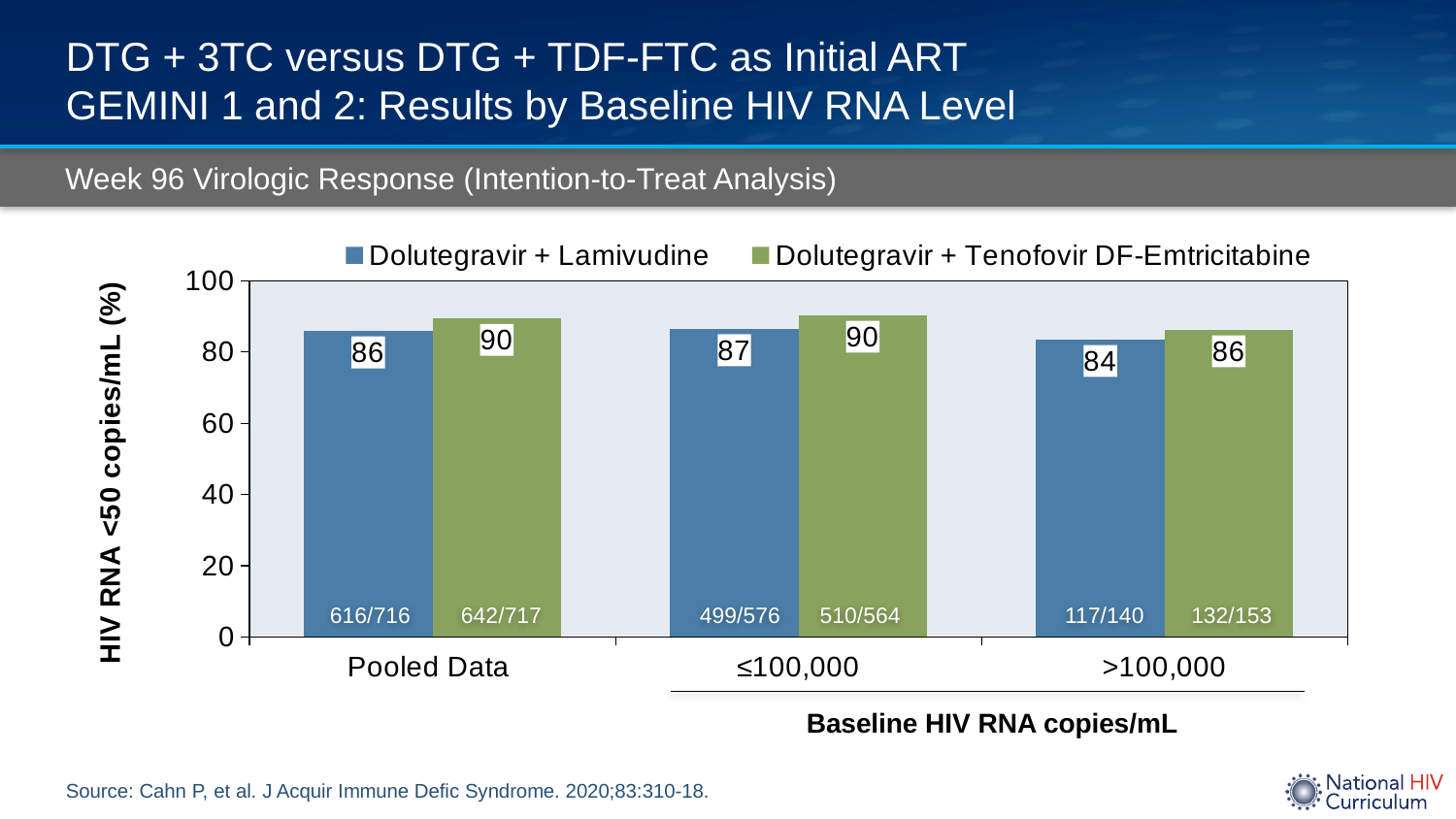
Which category has the lowest value for Dolutegravir + Lamivudine? >100,000 What fraction is printed on the Dolutegravir + Lamivudine bar in the ≤100,000 category? 499/576 What is the value for Dolutegravir + Tenofovir DF-Emtricitabine in the >100,000 category? 86 What is the label of the y axis? HIV RNA <50 copies/mL (%) Is the value for Dolutegravir + Lamivudine in the >100,000 category greater or less than 80? greater What is the value for Dolutegravir + Lamivudine in the ≤100,000 category? 87 What is the difference between the Dolutegravir + Tenofovir DF-Emtricitabine and Dolutegravir + Lamivudine values in the Pooled Data category? 4 How many categories are shown on the x axis? 3 How many series does the legend list? 2 In the >100,000 category, which series has the larger value? Dolutegravir + Tenofovir DF-Emtricitabine What is the value for Dolutegravir + Lamivudine in the Pooled Data category? 86 What kind of chart is shown on the slide? Bar chart